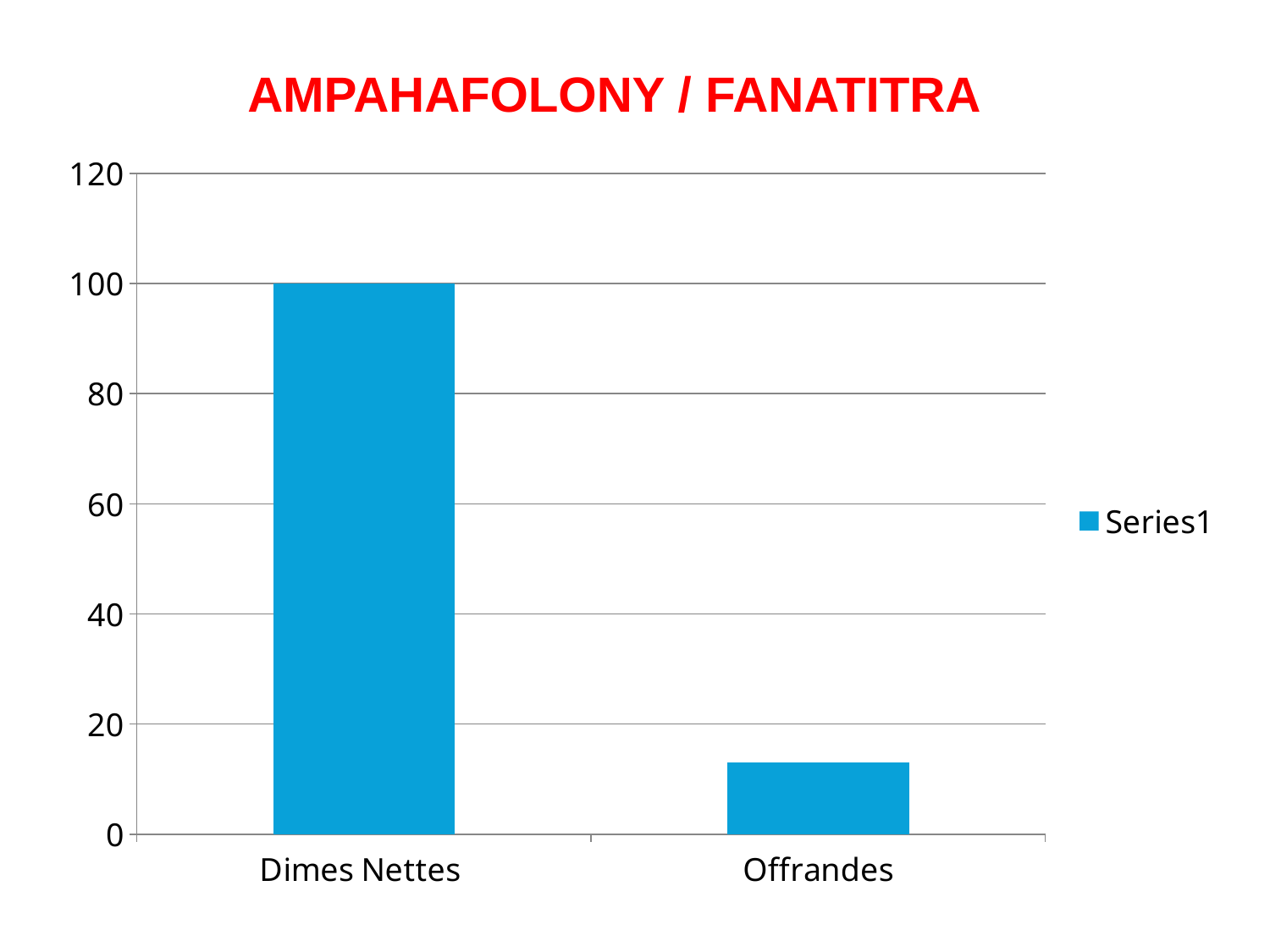
Do the values rise or fall from left to right along the x axis? fall What is the name of the series shown in the legend? Series1 What is the title of the chart? AMPAHAFOLONY / FANATITRA Which category has the highest value? Dimes Nettes How many series does the legend list? 1 What kind of chart is shown on the slide? Bar chart Which category has the lowest value? Offrandes Which is larger, the value for Dimes Nettes or the value for Offrandes? Dimes Nettes What is the value for Dimes Nettes? 100 How many categories are shown on the x axis of the chart? 2 Is the value for Dimes Nettes greater or less than 80? greater Is the value for Offrandes greater or less than 20? less